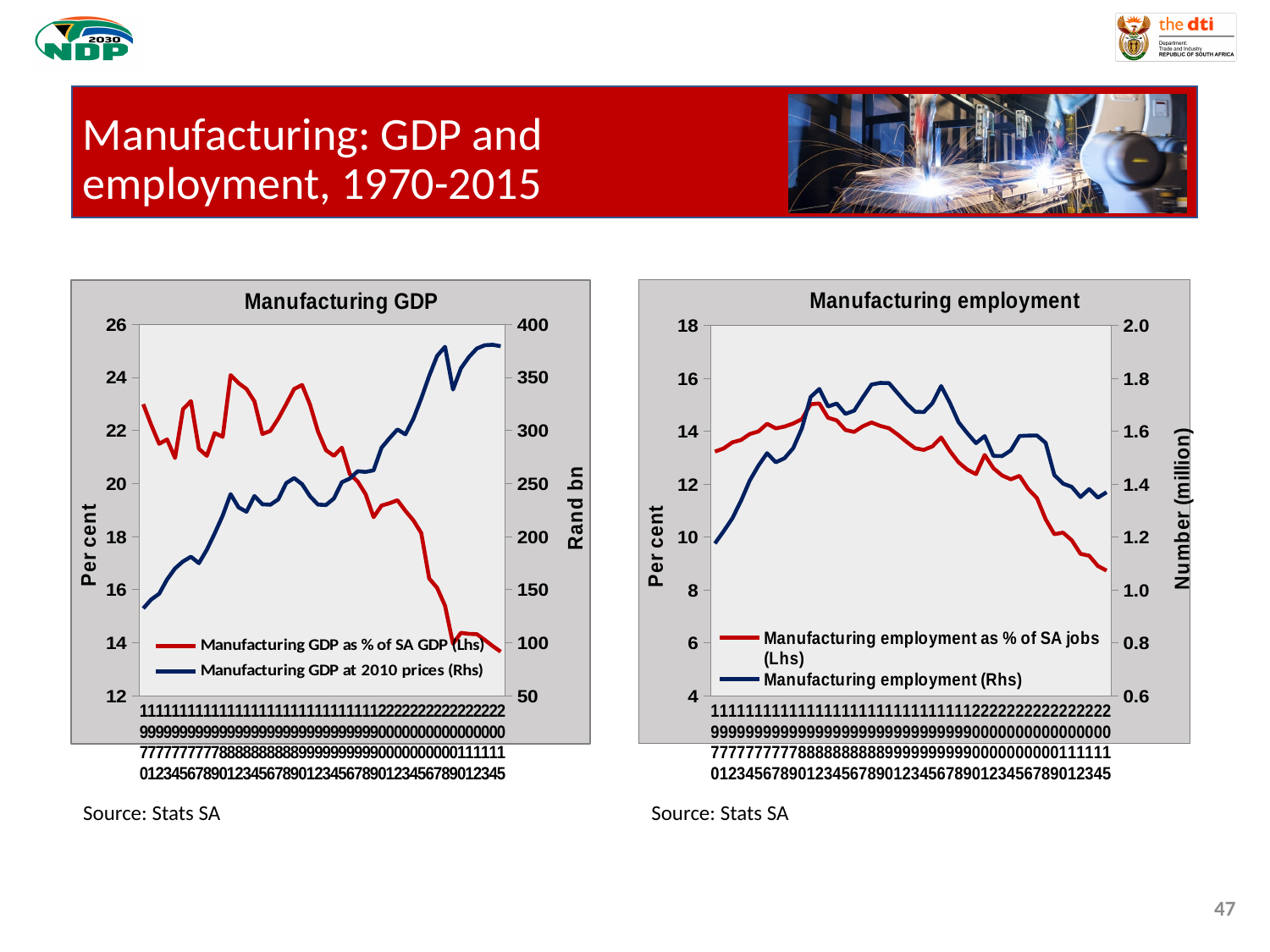
What is the label of the right-hand vertical axis of the "Manufacturing employment" chart? Number (million) What kind of chart is the "Manufacturing GDP" chart on the left? Line chart In the "Manufacturing GDP" chart, is the value of "Manufacturing GDP at 2010 prices (Rhs)" in 2015 greater or less than 350? greater How many series does the legend of the "Manufacturing GDP" chart list? 2 In the "Manufacturing employment" chart, does the series "Manufacturing employment as % of SA jobs (Lhs)" rise or fall overall from 1970 to 2015? Fall How many series does the legend of the "Manufacturing employment" chart list? 2 In the "Manufacturing GDP" chart, does the series "Manufacturing GDP as % of SA GDP (Lhs)" rise or fall overall from 1970 to 2015? Fall In the "Manufacturing employment" chart, is the value of "Manufacturing employment as % of SA jobs (Lhs)" in 2015 greater or less than 10? less What is the label of the right-hand vertical axis of the "Manufacturing GDP" chart? Rand bn In the "Manufacturing GDP" chart, does the series "Manufacturing GDP at 2010 prices (Rhs)" rise or fall overall from 1970 to 2015? Rise In the "Manufacturing GDP" chart, is the value of "Manufacturing GDP as % of SA GDP (Lhs)" in 1970 greater or less than 20? greater